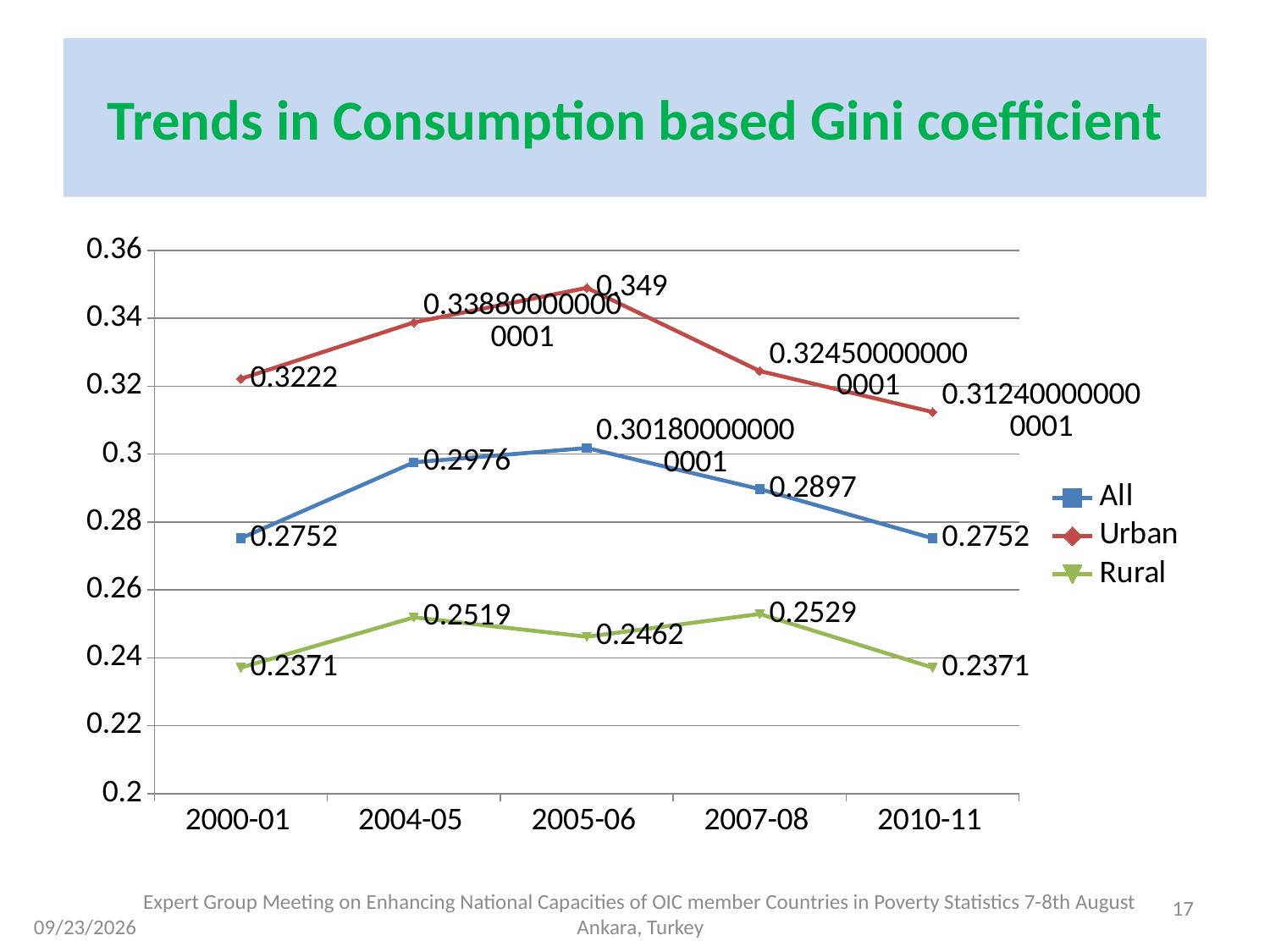
Is the Urban value for 2010-11 greater or less than 0.3? greater In which period is the Rural series at its lowest, 2000-01 or 2005-06? 2000-01 How many series does the legend list? 3 What is the title of the chart? Trends in Consumption based Gini coefficient What is the Rural Gini coefficient for 2007-08? 0.2529 What is the Urban Gini coefficient for 2005-06? 0.349 What type of chart is shown on the slide? line chart In which period is the Urban series at its highest? 2005-06 What is the difference between the Rural values for 2004-05 and 2000-01? 0.0148 Which is larger, the Urban value in 2000-01 or the All value in 2007-08? Urban value in 2000-01 How many time periods are shown on the x axis? 5 What is the value for All in 2004-05? 0.2976